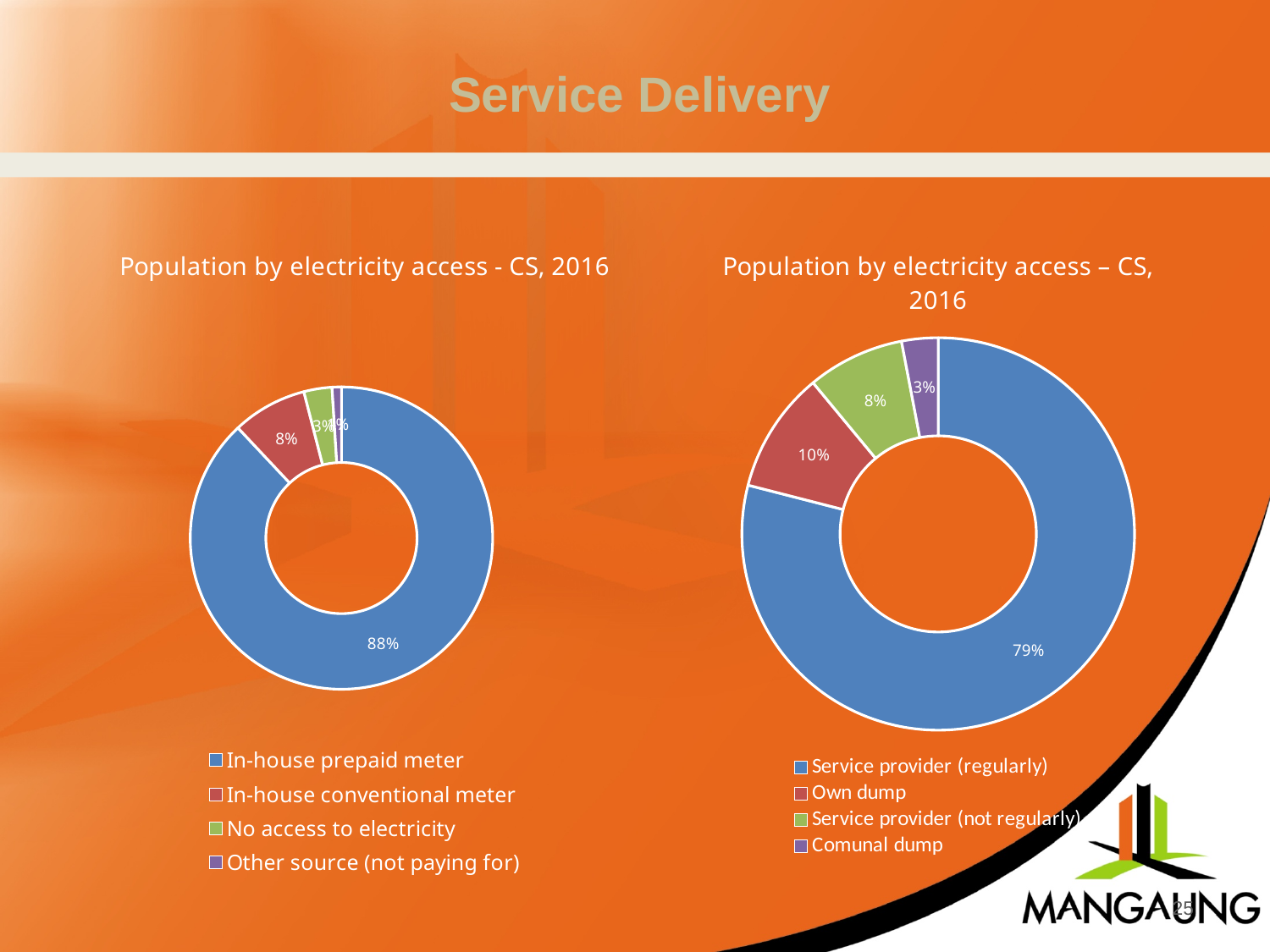
In the right chart, what percentage is shown for Own dump? 10% In the right chart, which is larger: Own dump or Service provider (not regularly)? Own dump In the right chart, which category has the smallest share? Comunal dump In the left chart, which category has the largest share? In-house prepaid meter In the left chart, what percentage is shown for in-house conventional meter? 8% In the left chart, what share of the population uses an in-house prepaid meter? 88% In the left chart, what is the difference between the in-house prepaid meter share and the in-house conventional meter share? 80 percentage points How many categories does the legend of the right chart list? 4 In the right chart, what percentage is shown for Comunal dump? 3% What type of chart is used on the left side of the slide? Doughnut chart In the right chart, what percentage is shown for Service provider (regularly)? 79% In the left chart, what percentage of the population has no access to electricity? 3%